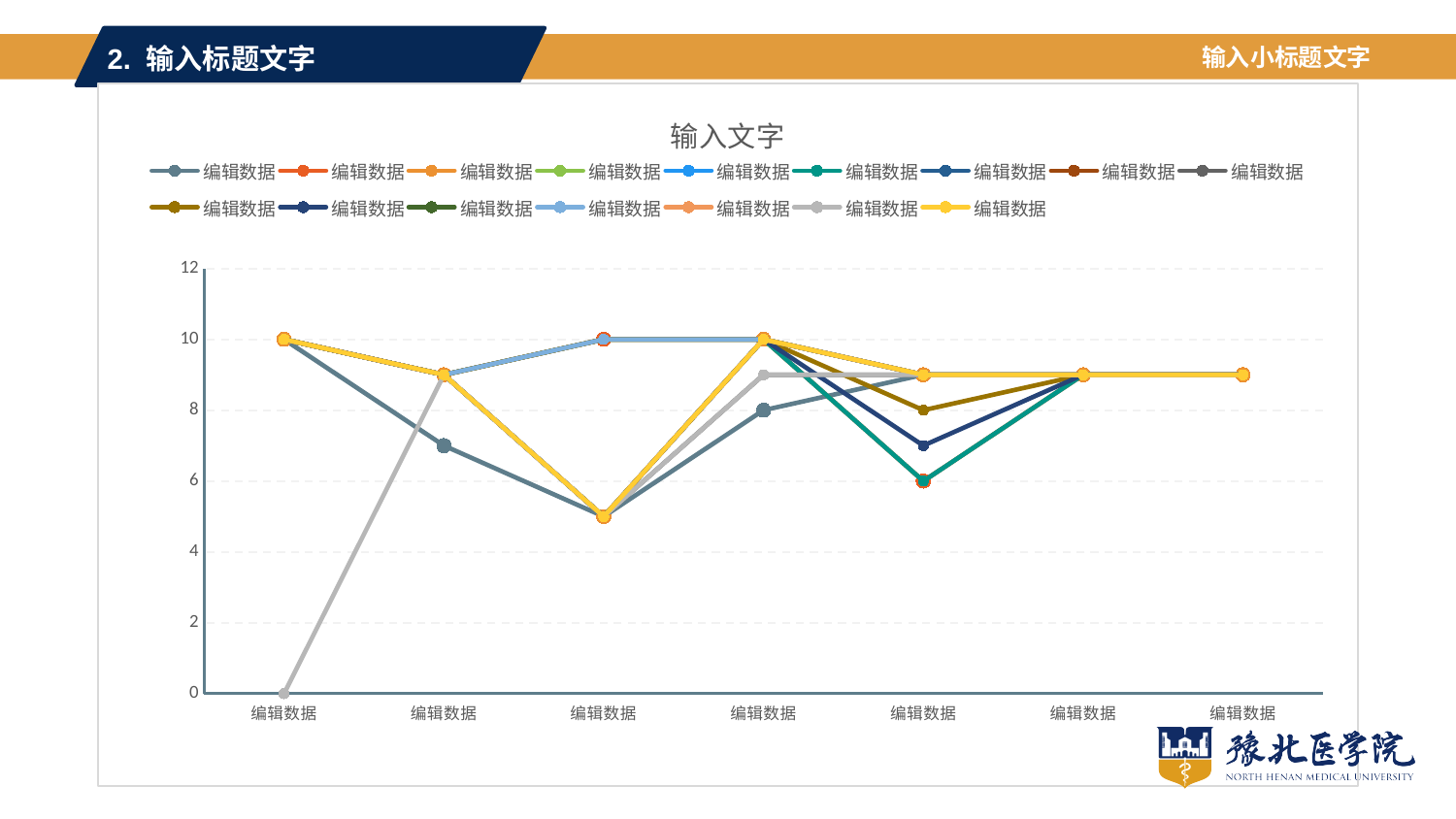
What is the highest value shown on the y axis? 12 What kind of chart is shown on the slide? line chart Does the light grey line rise or fall from the first category to the second category? rise Is the lowest value plotted at the third category greater or less than 6? less How many series does the legend list? 16 What is the value of the light grey line at the first (leftmost) category? 0 What is the lowest value reached by any line on the chart? 0 What is the highest value reached by any line on the chart? 10 What is the title of the chart? 输入文字 At the second category, is the dark slate-blue line higher or lower than the yellow line? lower What is the lowest value plotted at the fifth category? 6 How many categories are on the x axis? 7